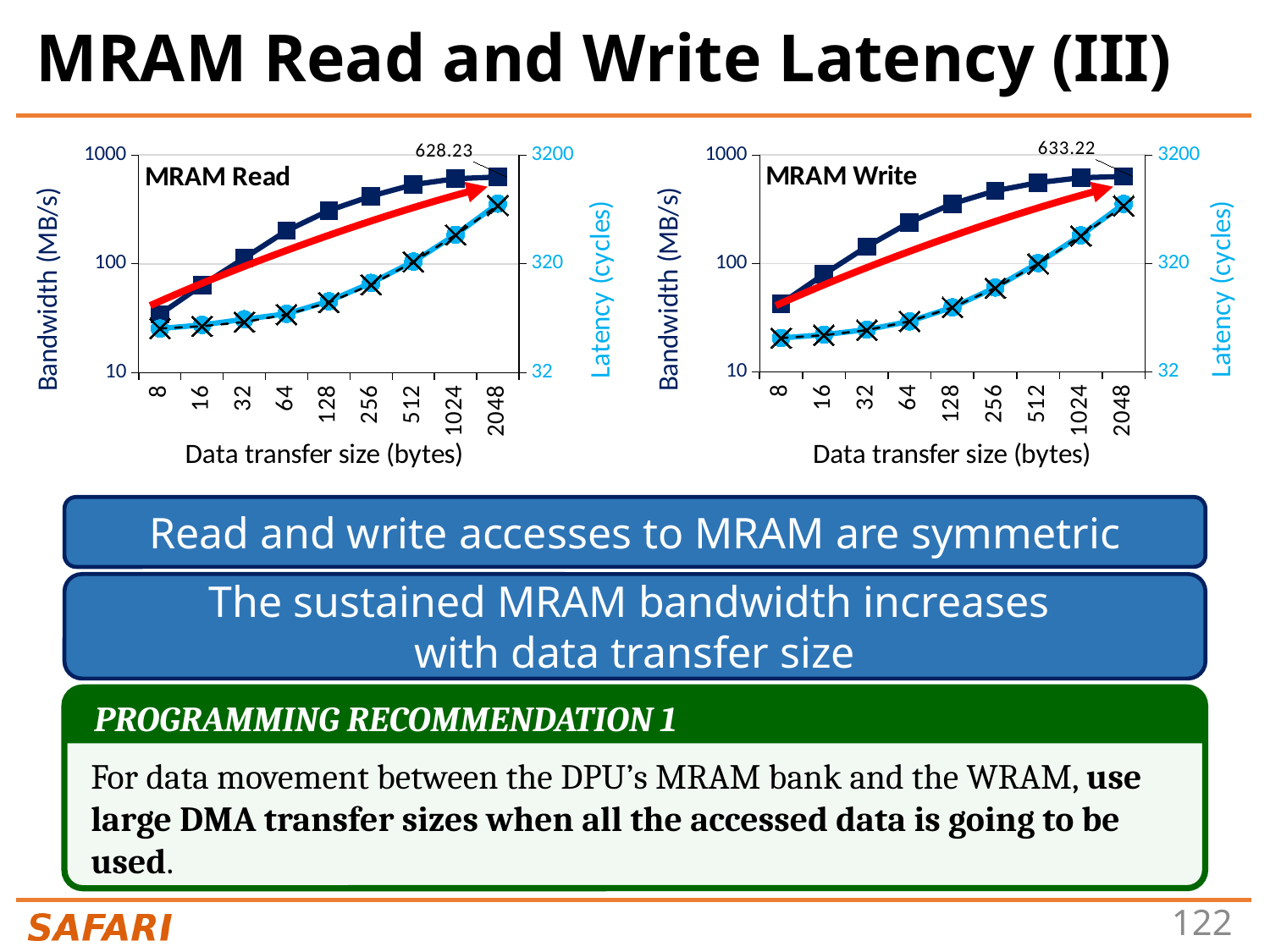
What is the difference between the labeled 2048-byte bandwidth in the MRAM Write chart and the one in the MRAM Read chart? 4.99 In the MRAM Read chart, what is the labeled bandwidth value at a data transfer size of 2048 bytes? 628.23 What kind of chart is the MRAM Write chart? Line chart In the MRAM Read chart, does bandwidth rise or fall as the data transfer size increases? Rises In the MRAM Write chart, does latency rise or fall as the data transfer size increases? Rises In the MRAM Write chart, what is the labeled bandwidth value at a data transfer size of 2048 bytes? 633.22 Which labeled peak bandwidth is larger: the MRAM Read chart's 2048-byte value or the MRAM Write chart's 2048-byte value? MRAM Write In the MRAM Read chart, at which data transfer size is the bandwidth highest? 2048 In the MRAM Read chart, is the bandwidth at 8 bytes greater or less than 100 MB/s? less How many data transfer sizes are plotted along the x axis of the MRAM Read chart? 9 What is the x-axis title of the MRAM Write chart? Data transfer size (bytes) In the MRAM Write chart, is the latency at 2048 bytes greater or less than 320 cycles? greater